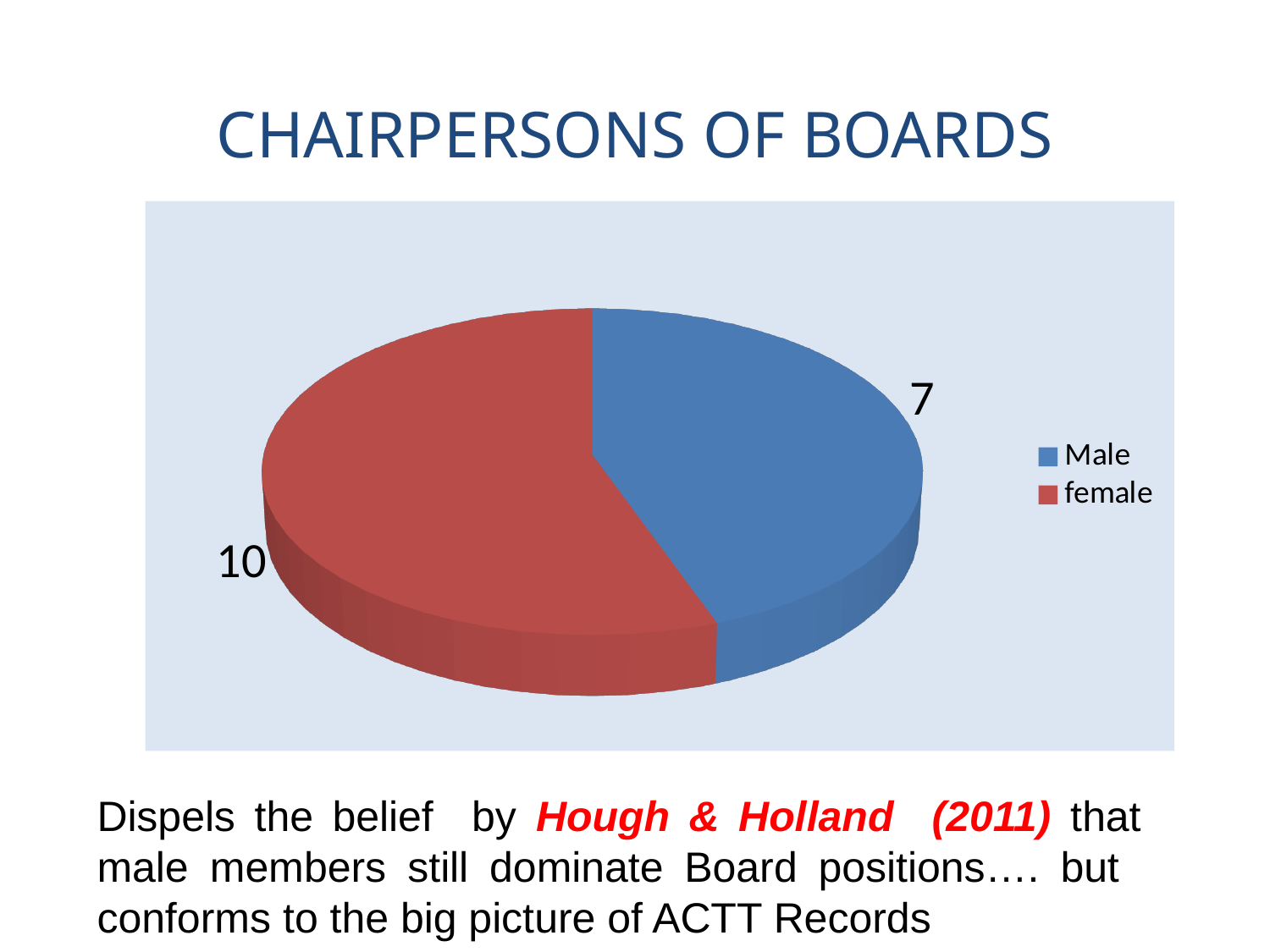
What colour is the female slice? red Which category has the largest slice? female What is the value for female? 10 Which is larger, the value for Male or the value for female? female What is the value for Male? 7 What kind of chart is shown on the slide? pie chart How many entries does the legend list? 2 How many slices does the pie chart have? 2 What is the total of all slices in the pie chart? 17 What is the title of the slide containing the chart? CHAIRPERSONS OF BOARDS Which category has the smallest slice? Male What is the difference between the female and Male values? 3